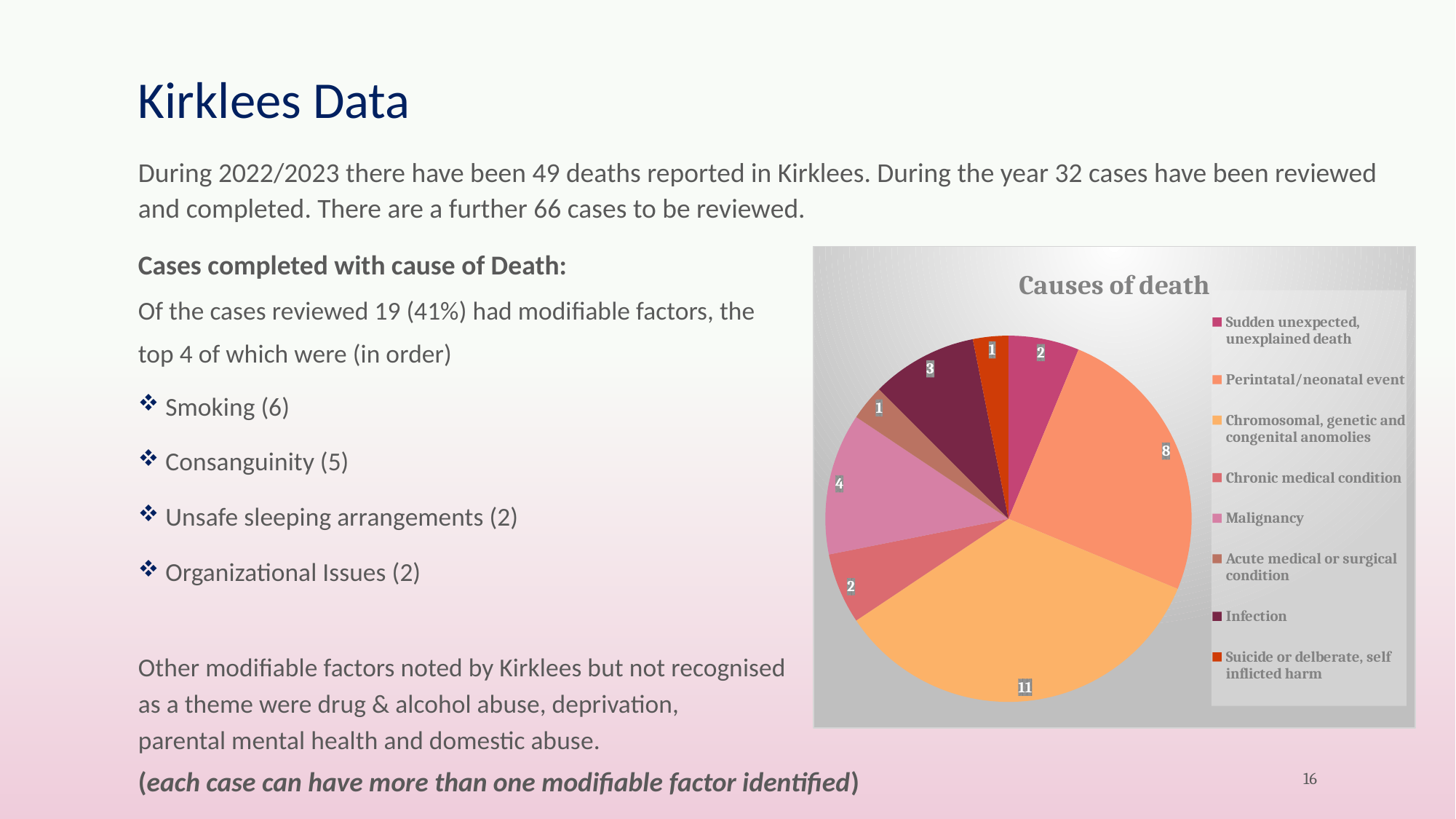
What is the value for Perinatal/neonatal event in the Causes of death pie chart? 8 What is the title of the pie chart? Causes of death Which cause of death has the largest slice in the pie chart? Chromosomal, genetic and congenital anomalies What is the difference between the values for Chromosomal, genetic and congenital anomalies and Perinatal/neonatal event? 3 What is the value for Infection in the Causes of death pie chart? 3 What type of chart is shown on the slide? Pie chart What is the value for Chromosomal, genetic and congenital anomalies in the Causes of death pie chart? 11 What is the value for Malignancy in the Causes of death pie chart? 4 What is the total of all the slice values in the Causes of death pie chart? 32 What share of the pie does Perinatal/neonatal event represent? 25% Which is larger in the pie chart: Malignancy or Infection? Malignancy How many slices does the Causes of death pie chart have? 8